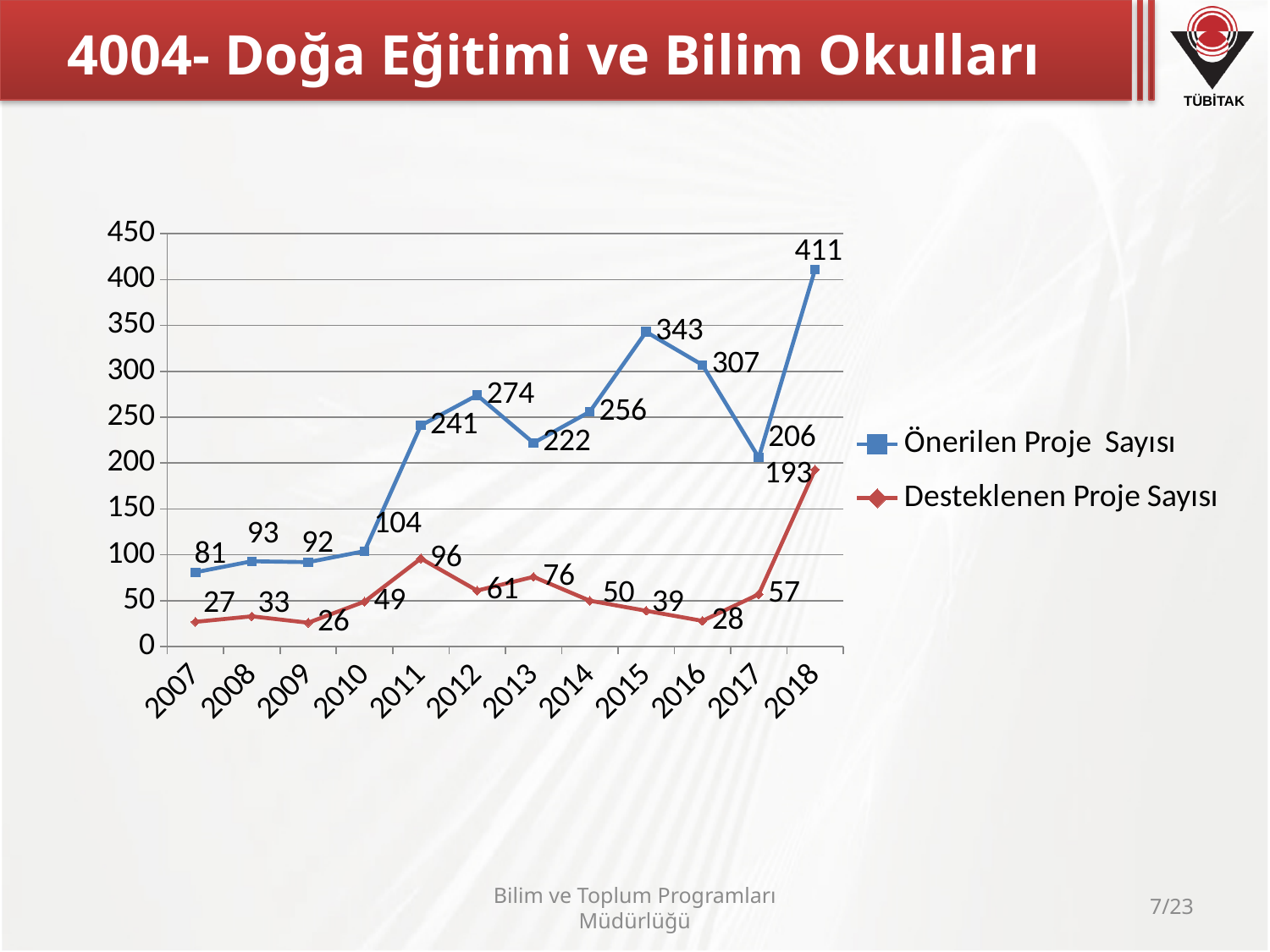
Does Önerilen Proje Sayısı rise or fall from 2016 to 2017? fall Is the value of Önerilen Proje Sayısı in 2015 greater or less than 300? greater What is the value of Önerilen Proje Sayısı in 2018? 411 How many series does the legend list? 2 What is the value of Desteklenen Proje Sayısı in 2011? 96 What is the difference between Önerilen Proje Sayısı and Desteklenen Proje Sayısı in 2018? 218 In which year is Önerilen Proje Sayısı highest? 2018 In which year is Desteklenen Proje Sayısı lowest? 2009 What is the value of Önerilen Proje Sayısı in 2013? 222 How many years are shown on the x axis? 12 What kind of chart is shown on the slide? line chart Which is larger: Desteklenen Proje Sayısı in 2012 or in 2013? 2013